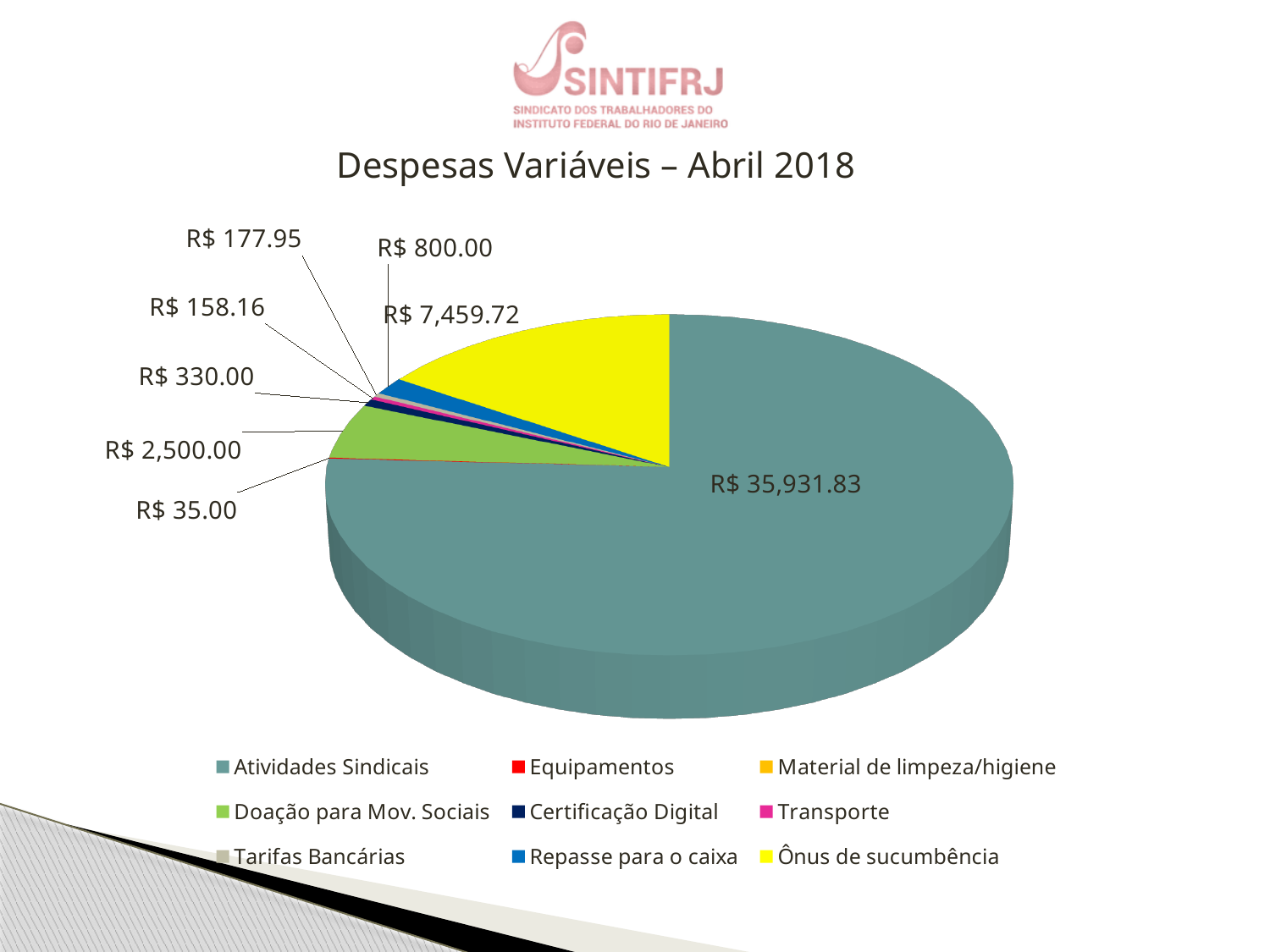
Which category has the largest slice of the pie? Atividades Sindicais Which is larger, the value for Ônus de sucumbência or the value for Doação para Mov. Sociais? Ônus de sucumbência What is the value for Repasse para o caixa? R$ 800.00 What is the value for Doação para Mov. Sociais? R$ 2,500.00 How many categories does the legend list? 9 What type of chart is shown on the slide? pie chart What is the difference between the values for Atividades Sindicais and Ônus de sucumbência? R$ 28,472.11 Which colour represents Ônus de sucumbência in the legend? yellow What is the difference between the values for Doação para Mov. Sociais and Repasse para o caixa? R$ 1,700.00 What is the title of the chart? Despesas Variáveis – Abril 2018 What is the value for Atividades Sindicais? R$ 35,931.83 What is the value for Ônus de sucumbência? R$ 7,459.72